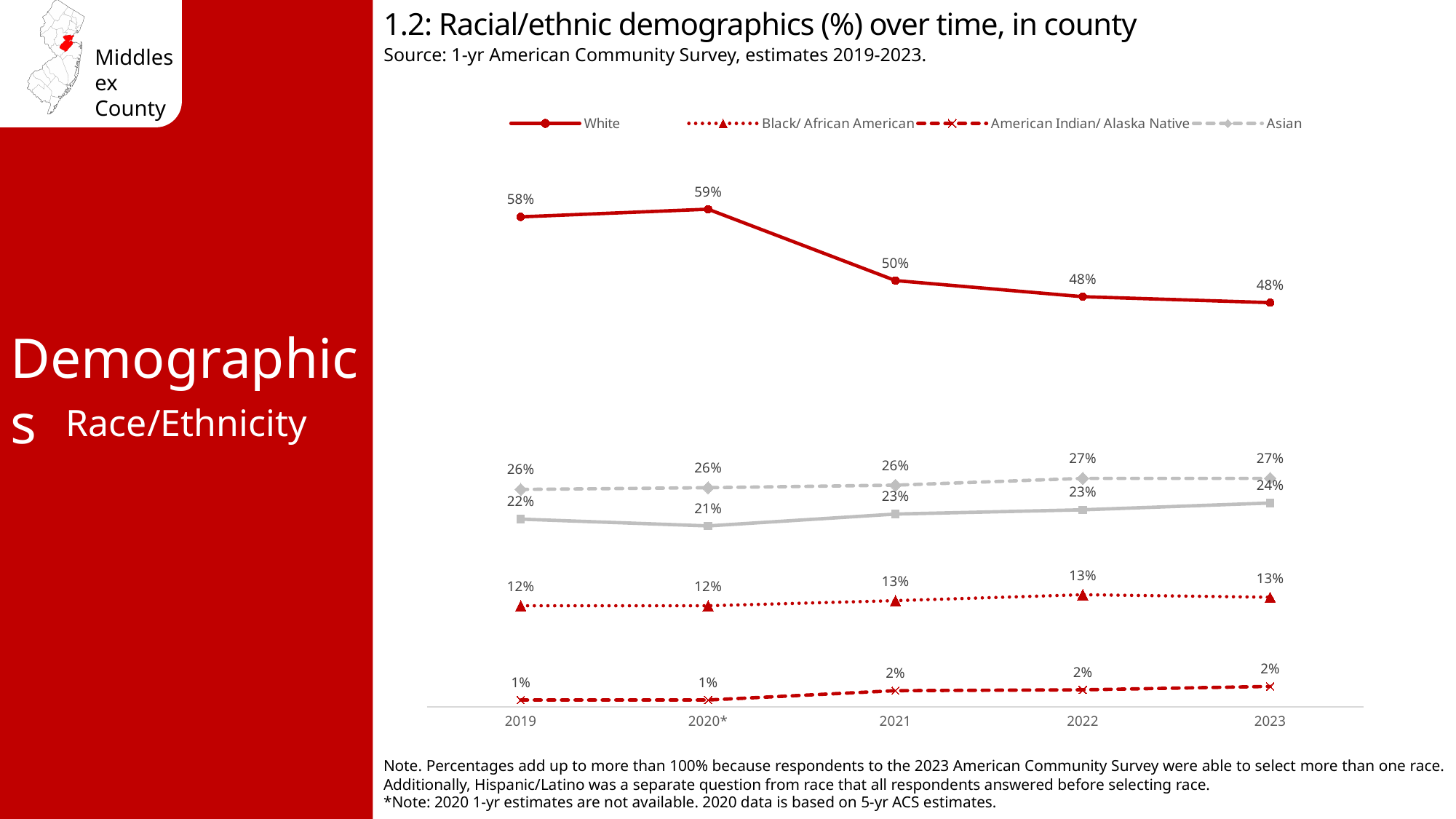
In which year was the White percentage highest? 2020* How many series does the legend list? 4 What was the Black/ African American percentage in 2021? 13% What was the American Indian/ Alaska Native percentage in 2020*? 1% Which is larger in 2022: the Asian percentage or the Black/ African American percentage? Asian What is the difference between the White percentage in 2020* and in 2023? 11% Does the White percentage rise or fall from 2020* to 2023? fall How many years are shown on the x axis? 5 What was the White percentage in 2019? 58% What type of chart is shown on the slide? line chart What is the source cited under the chart title? 1-yr American Community Survey, estimates 2019-2023 What was the Asian percentage in 2023? 27%